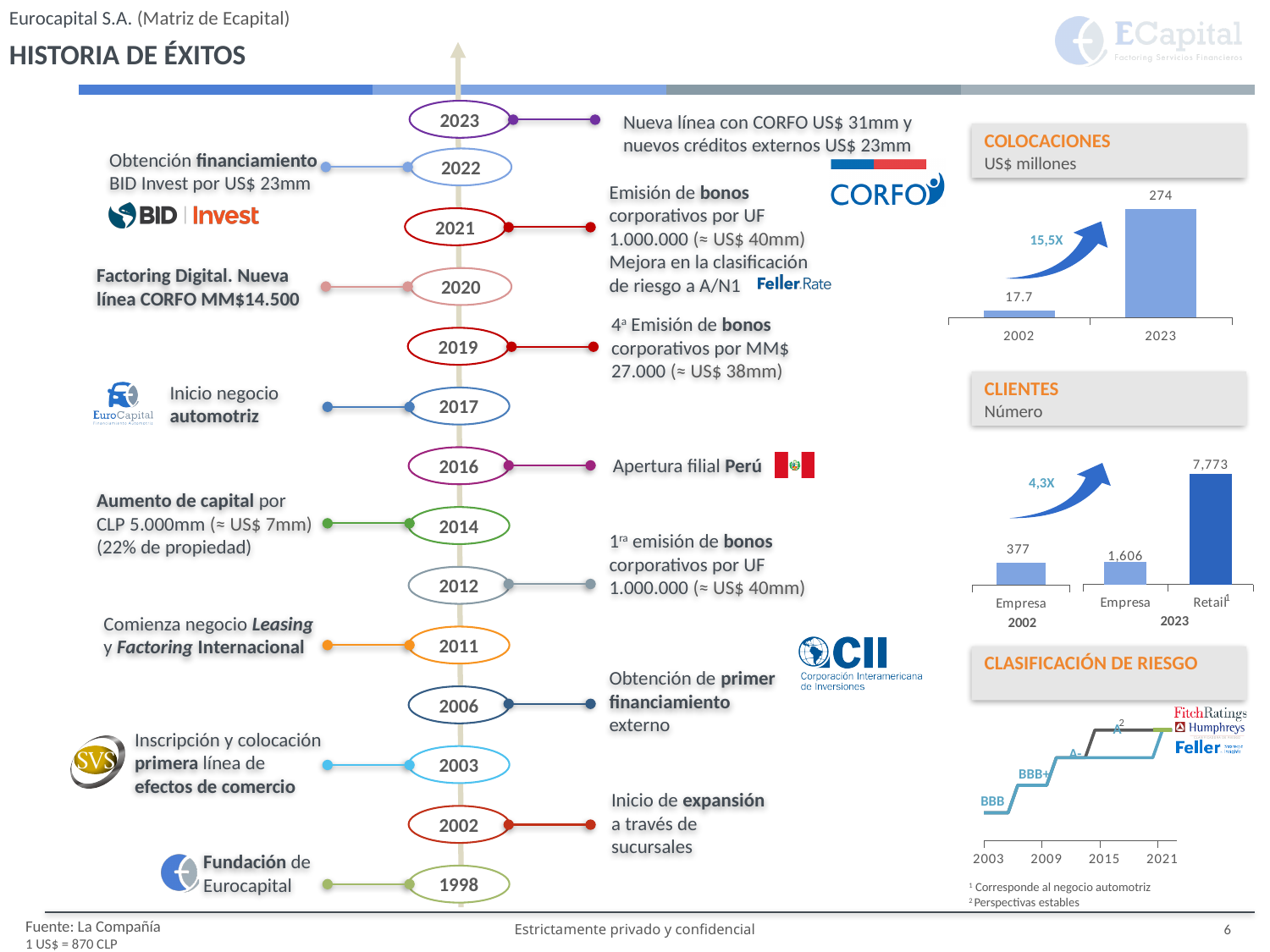
In the COLOCACIONES chart, what is the value for 2002? 17.7 In the CLIENTES chart, what is the value for Empresa in 2002? 377 In the CLIENTES chart, what is the value for Retail in 2023? 7,773 In the CLIENTES chart, what is the difference between Empresa 2023 and Empresa 2002? 1,229 In the COLOCACIONES chart, what is the value for 2023? 274 In the COLOCACIONES chart, what is the difference between the 2023 and 2002 values? 256.3 In the COLOCACIONES chart, which year has the higher value? 2023 In the CLIENTES chart, how many bars are plotted? 3 In the CLIENTES chart, which category has the lowest value? Empresa 2002 In the CLIENTES chart, what is the value for Empresa in 2023? 1,606 What growth multiple is shown on the arrow in the CLIENTES chart? 4,3X What kind of chart is the COLOCACIONES chart? Bar chart